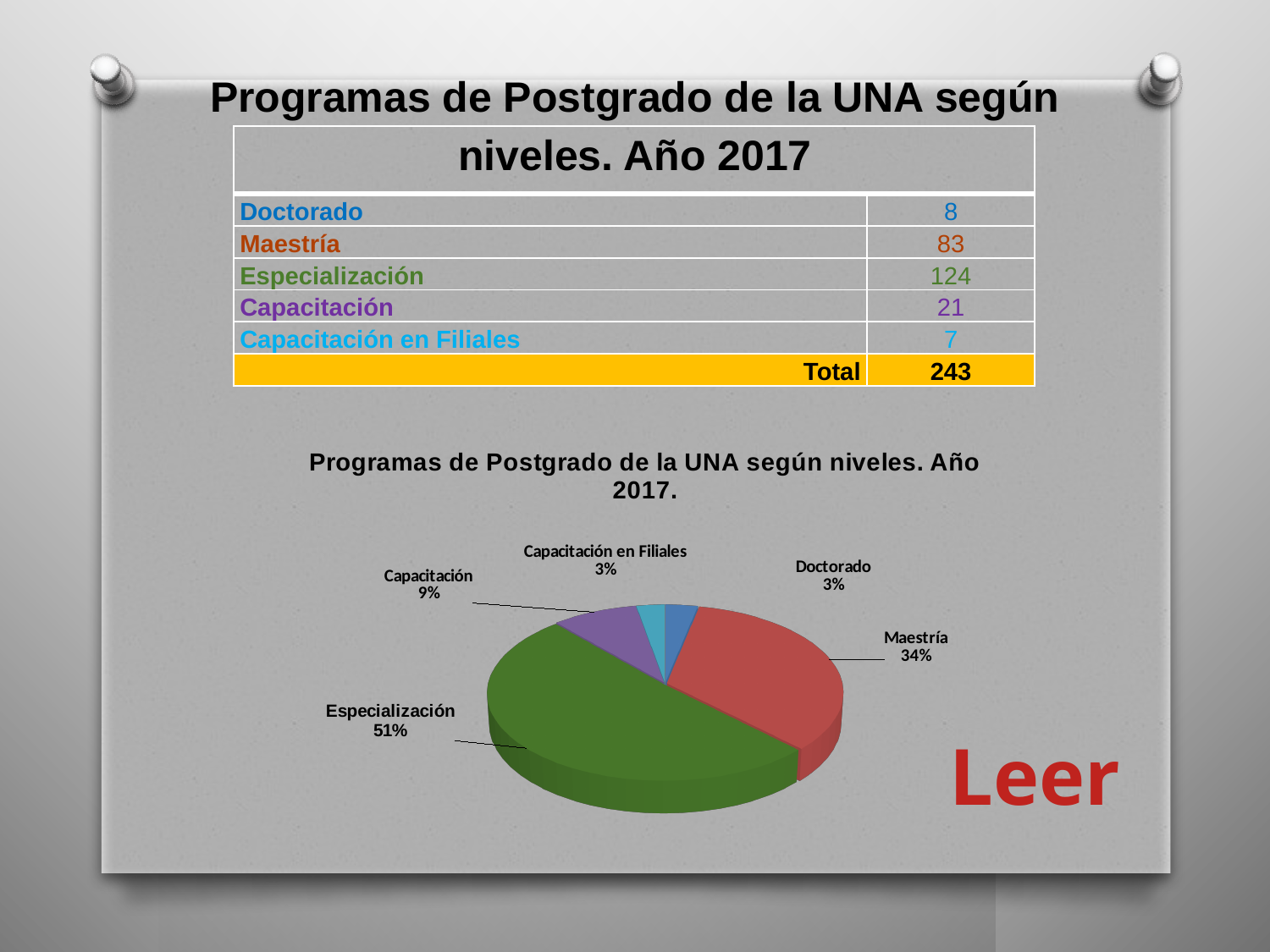
What is the difference in percentage points between the Especialización and Maestría slices? 17 percentage points What percentage is shown for Capacitación in the pie chart? 9% What percentage is shown for Capacitación en Filiales in the pie chart? 3% What share of the pie does Maestría represent? 34% What is the title of the pie chart? Programas de Postgrado de la UNA según niveles. Año 2017. Which slice is larger, Maestría or Capacitación? Maestría How many slices does the pie chart have? 5 What colour is the Especialización slice in the pie chart? green What percentage is shown for Doctorado in the pie chart? 3% What share of the pie does Especialización represent? 51% Which category has the largest slice of the pie? Especialización What kind of chart is shown on the slide? pie chart